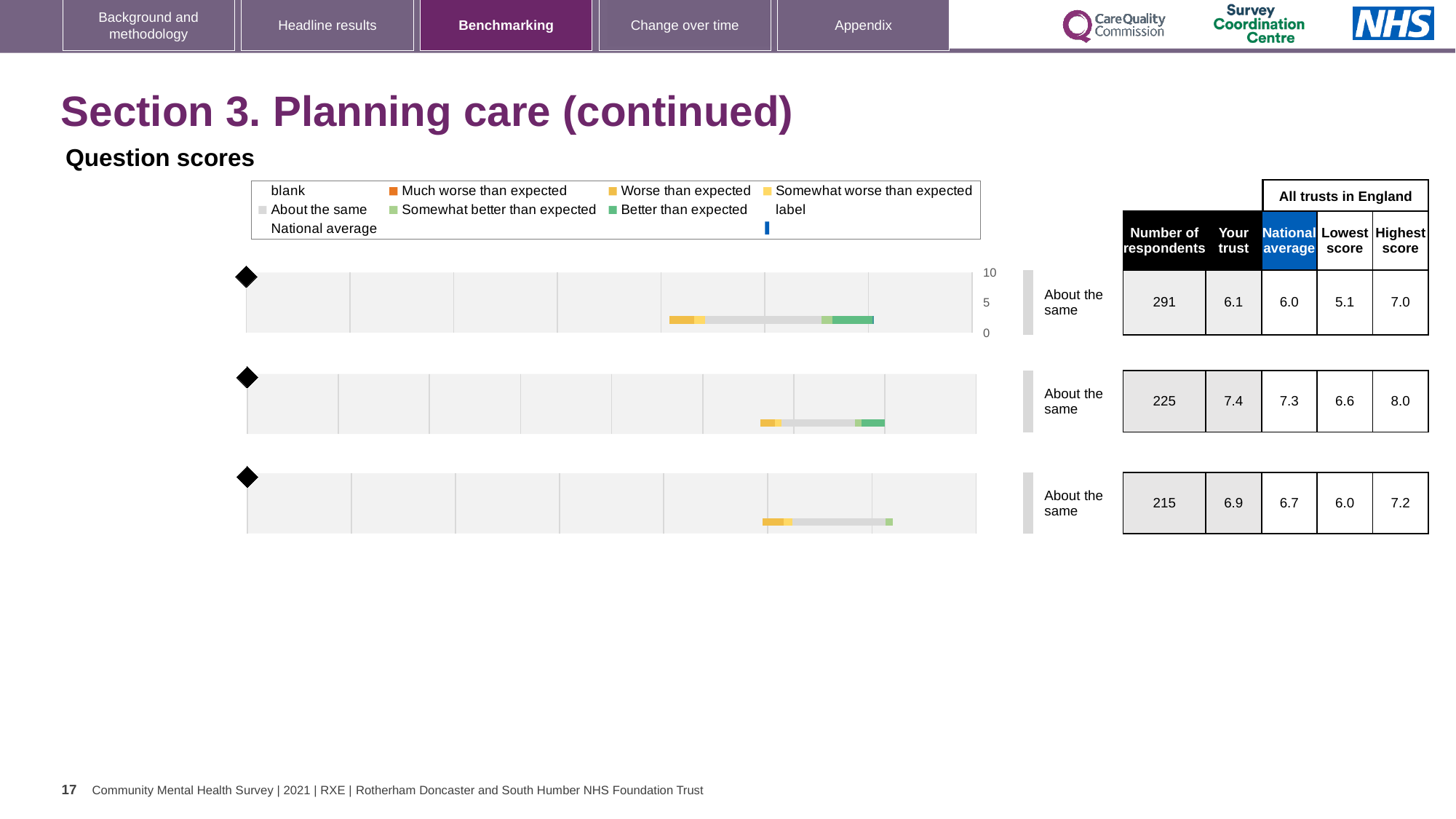
For the top chart, which is larger: the 'Your trust' score or the national average? Your trust For the middle chart, what is the 'Your trust' score? 7.4 What kind of chart is used to show the question scores on this slide? bar chart Which legend entry is shown in orange? Much worse than expected For the bottom chart, what is the difference between the 'Your trust' score and the national average? 0.2 For the bottom chart, what is the national average score? 6.7 For the top chart, what is the number of respondents? 291 How many question score charts are shown on the slide? 3 Which chart (top, middle or bottom) has the lowest number of respondents? bottom Which chart (top, middle or bottom) has the highest 'Your trust' score? middle For the middle chart, what is the difference between the highest score and the lowest score? 1.4 What benchmark category is shown next to the top chart? About the same